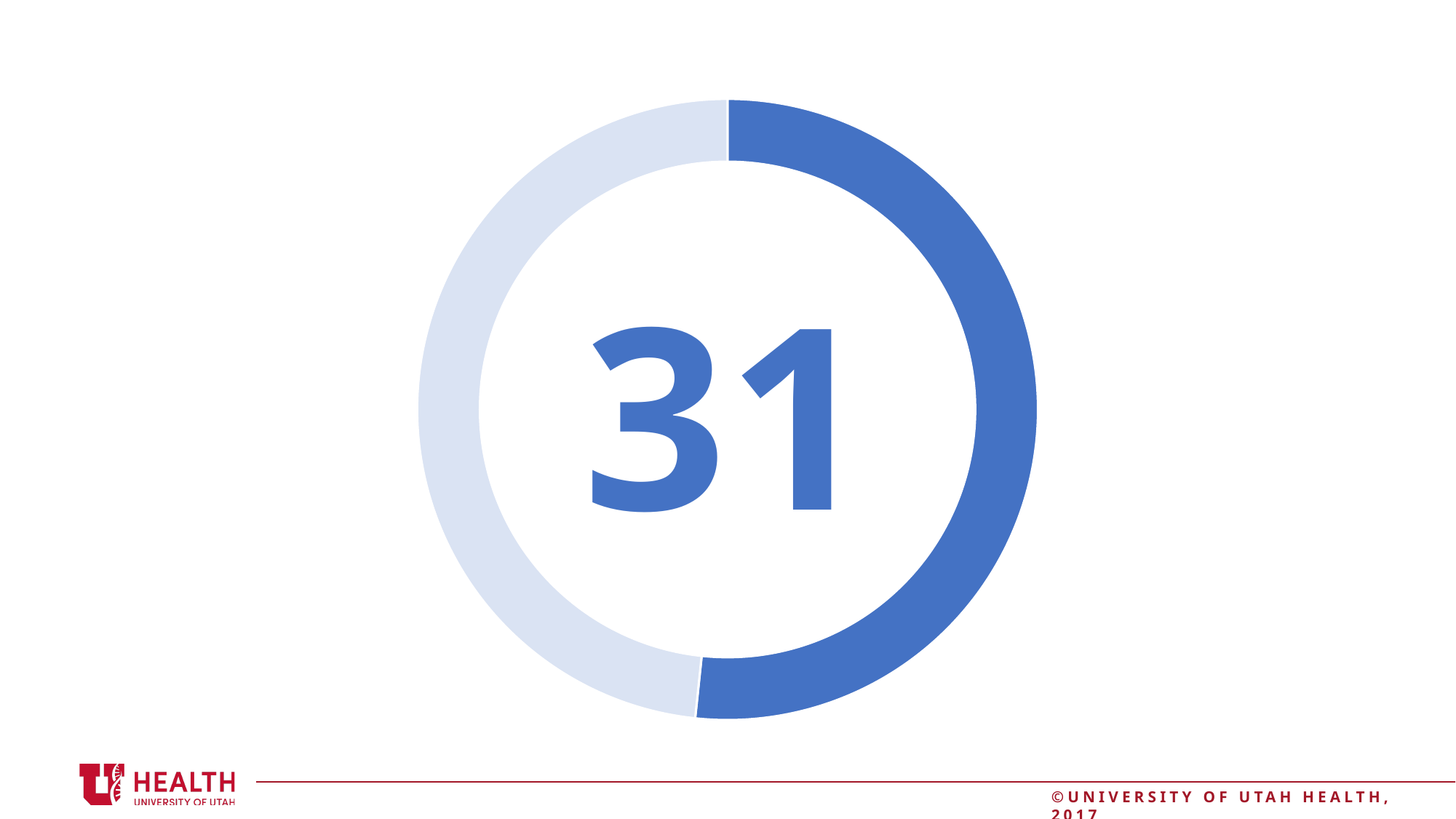
How many segments does the doughnut chart have? 2 What number is displayed in the centre of the doughnut chart? 31 What kind of chart is shown on the slide? Doughnut chart Does the doughnut chart have a legend? No What colour is the segment that starts at the top of the ring and runs clockwise down the right side? Dark blue